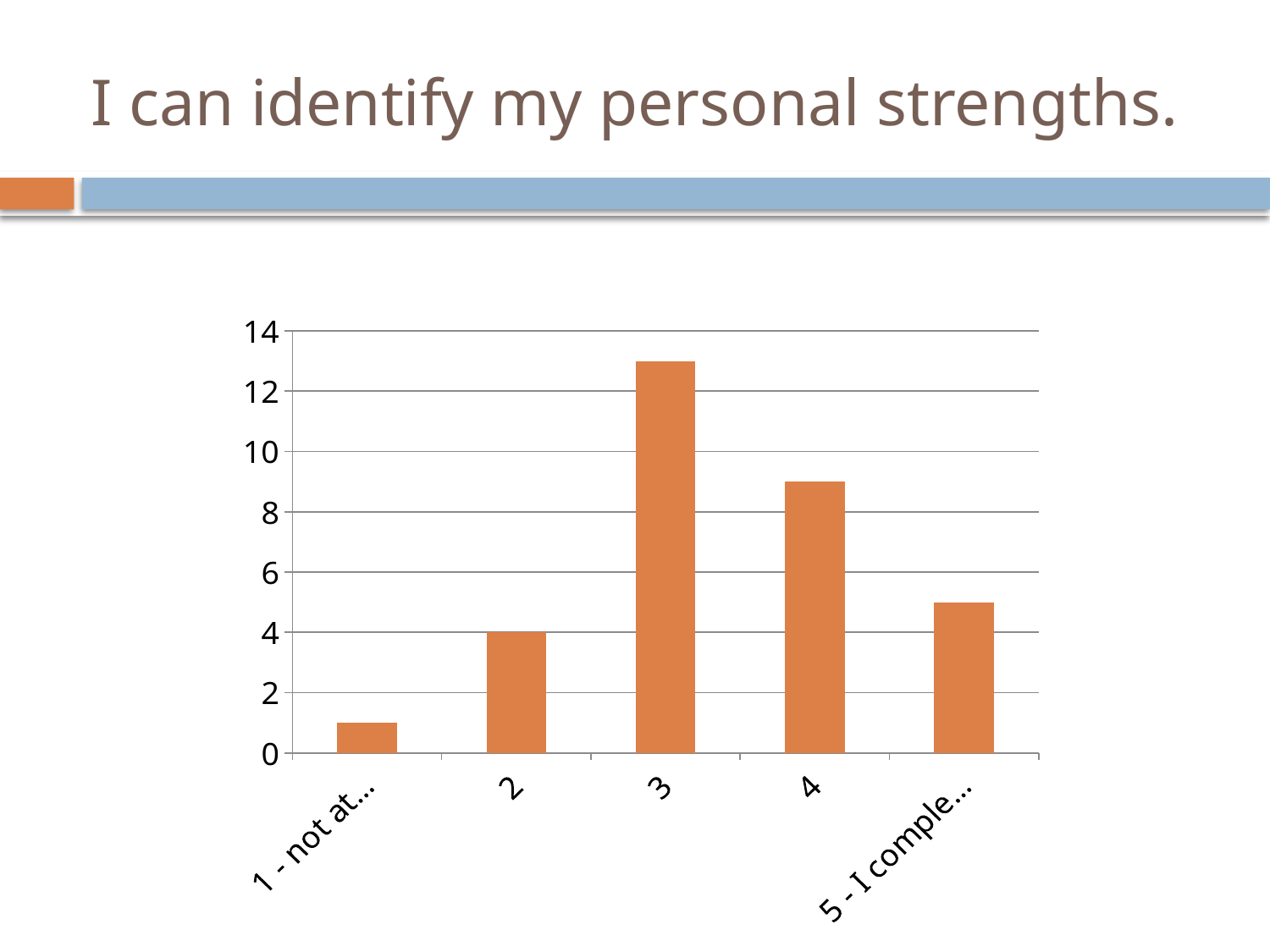
What is the title of the slide containing the chart? I can identify my personal strengths. Is the value for the category '5 - I comple...' greater or less than 6? less Is the value for category 4 greater or less than 8? greater Which is larger, the value for category 3 or the value for category 4? 3 How many categories are shown on the x axis of the chart? 5 Which category has the highest bar? 3 Is the value for category 4 greater or less than 10? less What is the value for category 2? 4 What kind of chart is shown on the slide? bar chart Which category has the lowest bar? 1 - not at... Do the values rise or fall from category 3 to category 5? fall